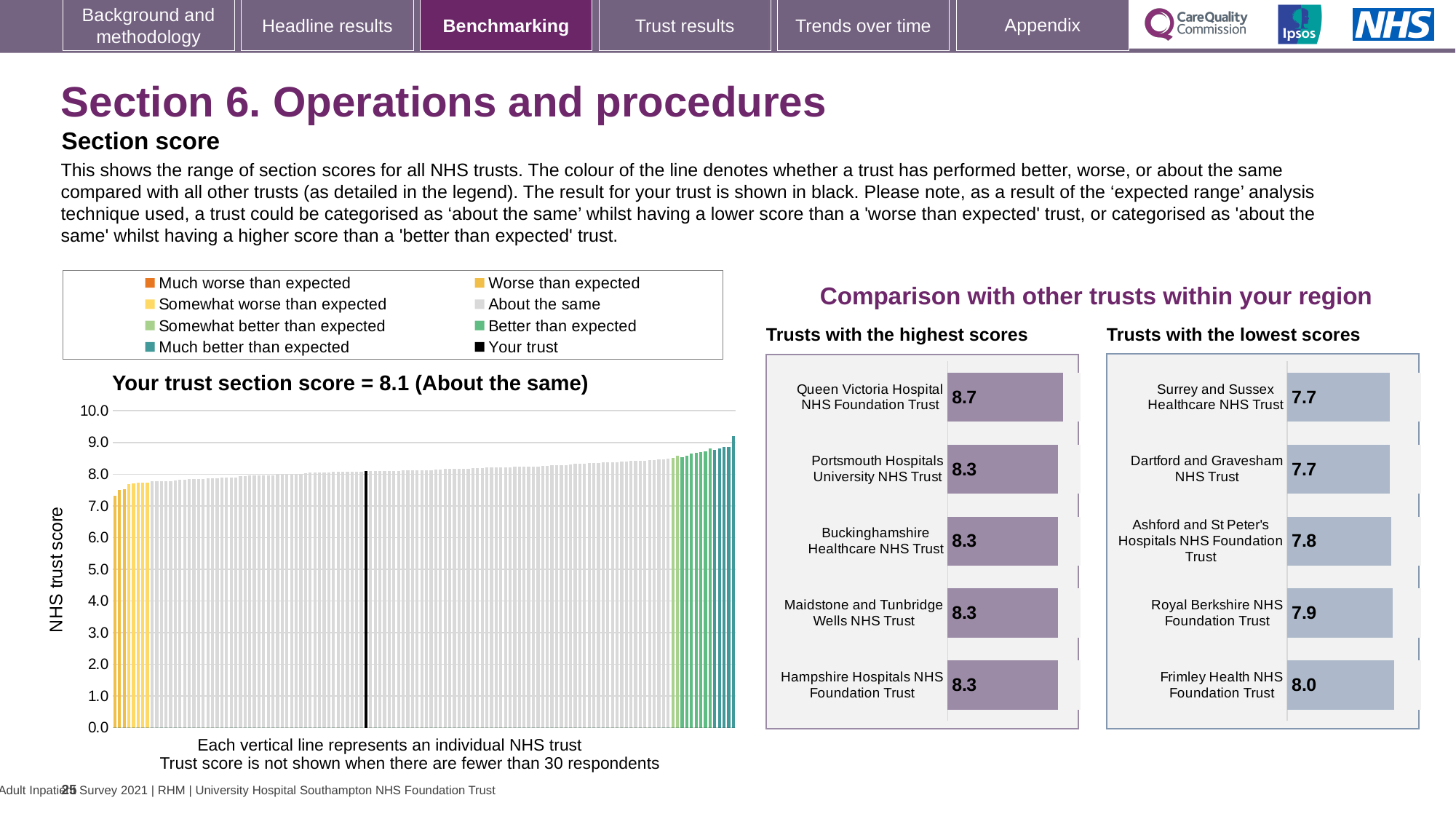
On the 'Trusts with the highest scores' chart, what is the difference between the scores of Queen Victoria Hospital NHS Foundation Trust and Hampshire Hospitals NHS Foundation Trust? 0.4 On the 'Your trust section score' chart, is the value of the lowest (leftmost) bar greater or less than 8.0? less What kind of chart is the 'Your trust section score' chart? bar chart On the 'Trusts with the highest scores' chart, which trust has the highest score? Queen Victoria Hospital NHS Foundation Trust How many trusts are shown on the 'Trusts with the lowest scores' chart? 5 On the 'Your trust section score' chart, do the trust scores rise or fall from left to right? rise What is the y-axis label on the 'Your trust section score' chart? NHS trust score How many entries does the legend above the 'Your trust section score' chart list? 8 On the 'Trusts with the highest scores' chart, what is the score for Queen Victoria Hospital NHS Foundation Trust? 8.7 On the 'Your trust section score' chart, what is the section score for your trust? 8.1 On the 'Trusts with the lowest scores' chart, which has the higher score: Royal Berkshire NHS Foundation Trust or Ashford and St Peter's Hospitals NHS Foundation Trust? Royal Berkshire NHS Foundation Trust On the 'Trusts with the lowest scores' chart, what is the score for Frimley Health NHS Foundation Trust? 8.0